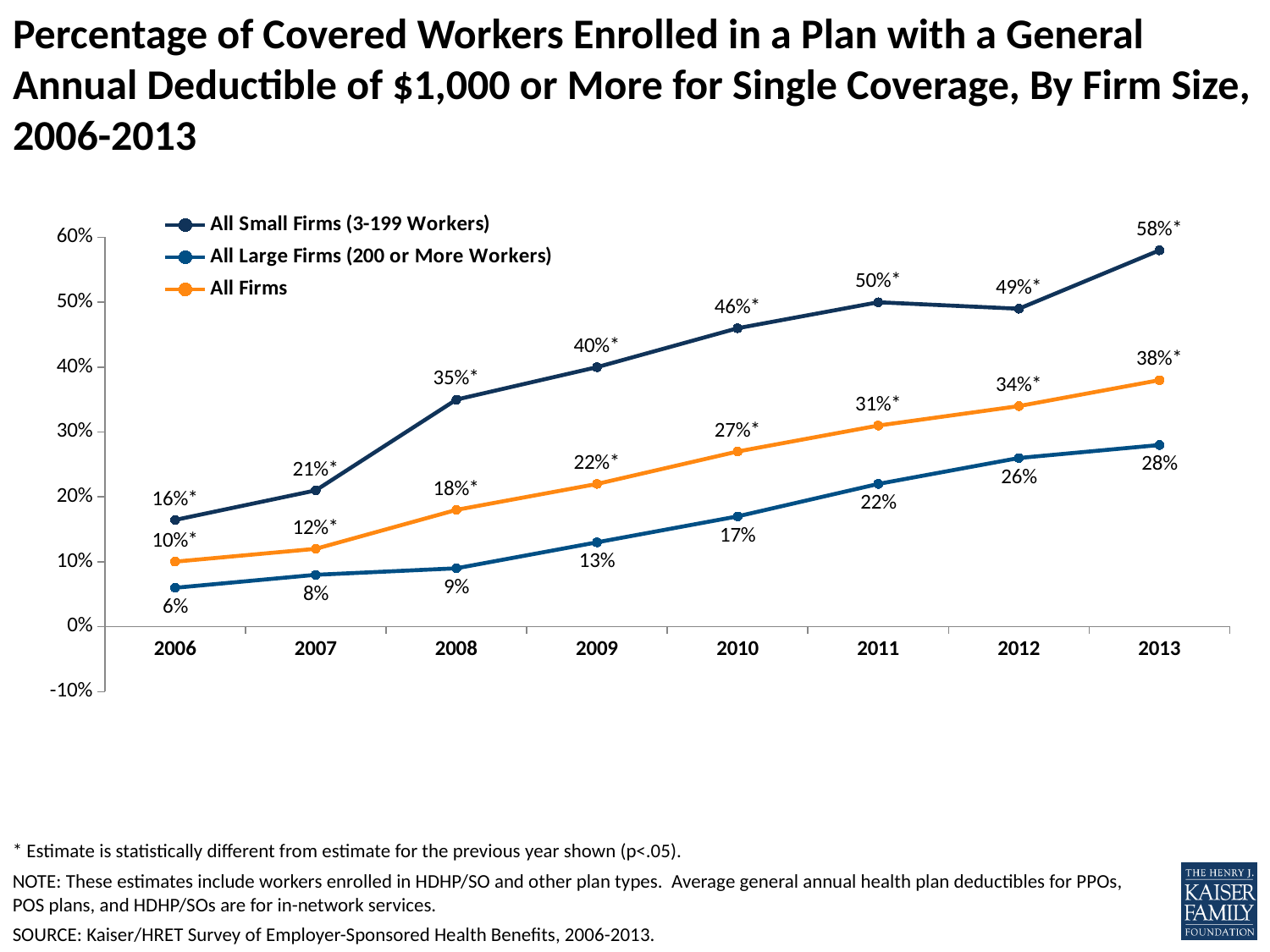
What is the difference between the All Small Firms and All Large Firms values in 2013? 30 percentage points Which is larger in 2009: the value for All Firms or the value for All Large Firms (200 or More Workers)? All Firms What kind of chart is shown on the slide? Line chart How many series does the legend list? 3 Does the value for All Firms rise or fall from 2006 to 2013? Rise What is the value for All Large Firms (200 or More Workers) in 2006? 6% Is the value for All Small Firms (3-199 Workers) in 2011 greater or less than 40%? greater In which year is the value for All Small Firms (3-199 Workers) lowest? 2006 In which year is the value for All Large Firms (200 or More Workers) highest? 2013 What is the value for All Small Firms (3-199 Workers) in 2013? 58% What is the value for All Firms in 2010? 27% How many years are shown on the x axis? 8